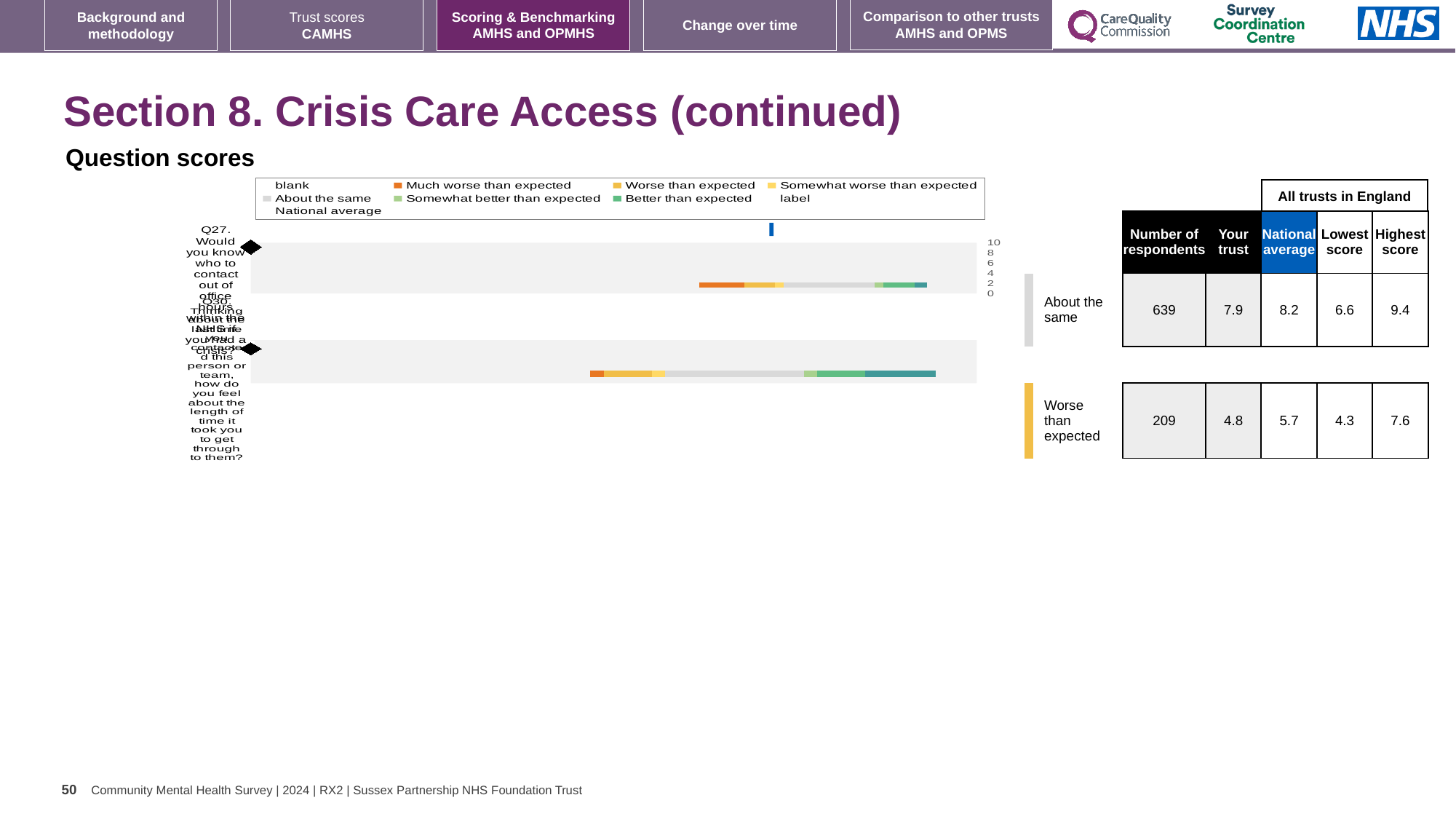
For Q30, what is the difference between the highest score (7.6) and the lowest score (4.3) across all trusts in England? 3.3 What kind of chart is shown under 'Question scores'? Bar chart In the table beside the chart, what is the national average for Q30 (how do you feel about the length of time it took you to get through)? 5.7 In the table beside the chart, what is the 'Your trust' score for Q27? 7.9 Which question has the higher 'Your trust' score, Q27 or Q30? Q27 How many questions (bars) are plotted in the chart? 2 For Q27, which is larger: the 'Your trust' score or the national average? National average What is the highest value shown on the chart's numeric axis? 10 In the chart legend, which colour represents 'Much worse than expected'? Orange In the table beside the chart, how many respondents answered Q30? 209 In the table beside the chart, how many respondents answered Q27 (Would you know who to contact out of office hours)? 639 What benchmark category is shown for Q30? Worse than expected